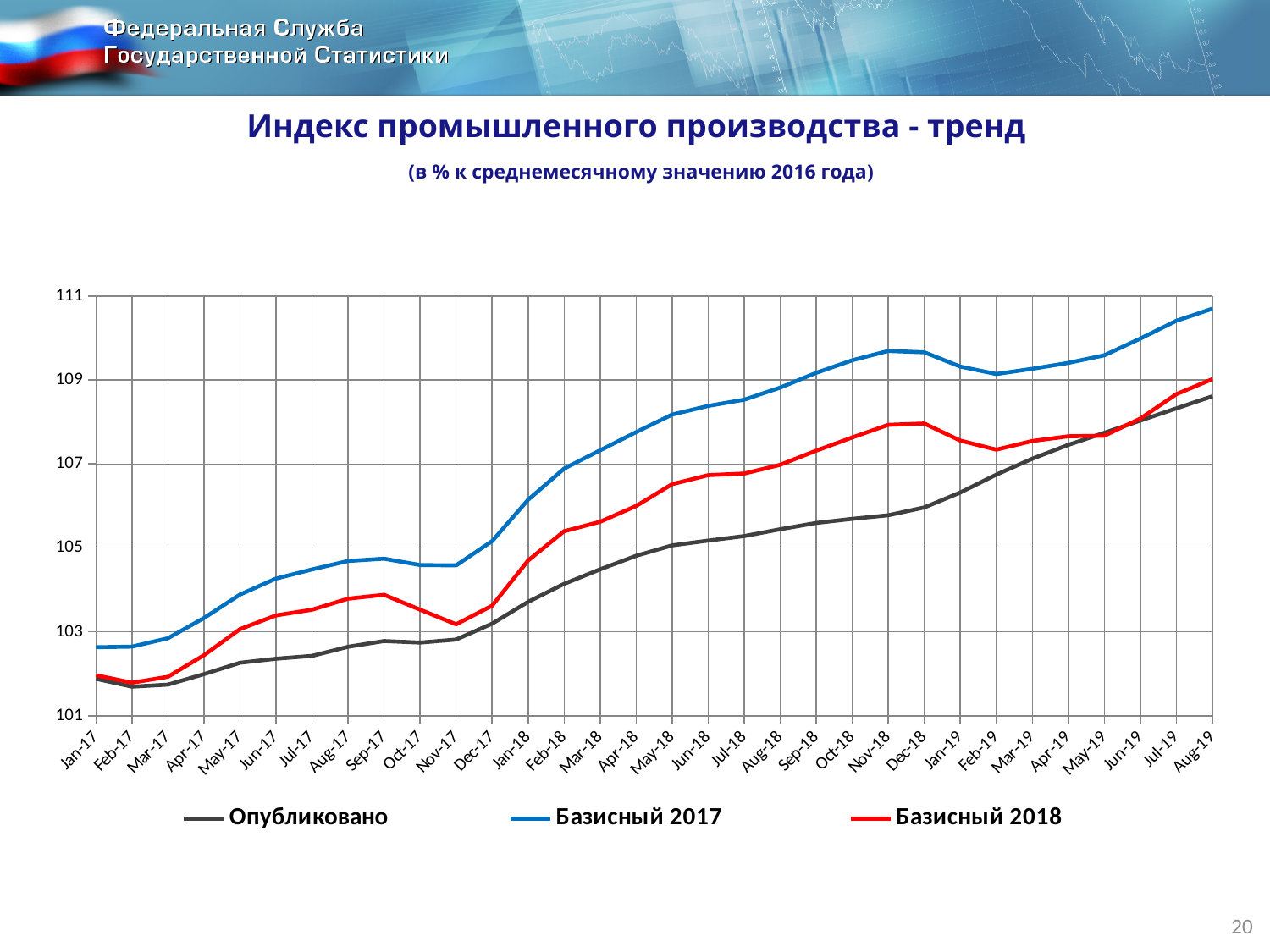
How many monthly points are plotted along the x axis, from Jan-17 to Aug-19? 32 How many series does the legend list? 3 In which month does the Базисный 2017 series reach its highest value? Aug-19 What colour is the line for the Базисный 2018 series? red In Aug-19, which is higher: Базисный 2017 or Опубликовано? Базисный 2017 Is the value of Опубликовано in Jan-17 greater or less than 103? less Which series reaches the highest value on the chart? Базисный 2017 Is the value of Базисный 2017 in Aug-19 greater or less than 109? greater Is the value of Опубликовано in Aug-19 greater or less than 109? less What kind of chart is shown on the slide? line chart Does the Опубликовано series rise or fall overall from Jan-17 to Aug-19? rise